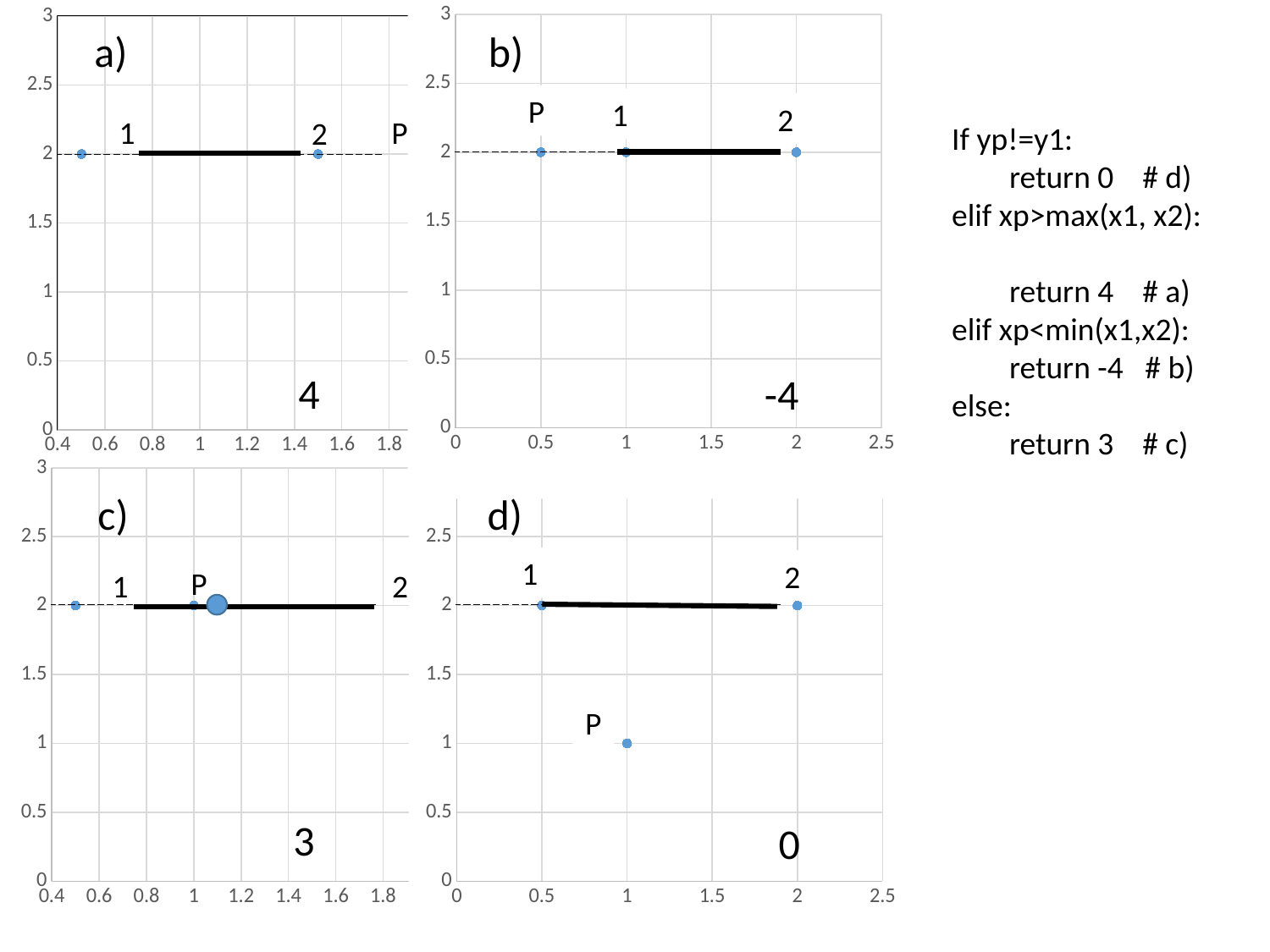
In chart d), what is the x value of point P? 1 In chart b), what is the x value of point P? 0.5 What number is printed in the lower right of chart b)? -4 How many charts are shown on the slide? 4 In chart b), which point has the largest x value? 2 In chart c), which has the larger x value, point 1 or point P? P In chart a), is the x value of point P greater or less than 1.5? greater What kind of chart is chart a)? scatter chart In chart d), what is the y value of point P? 1 In chart b), what is the x value of point 2? 2 In chart d), which point has the lowest y value? P In chart d), what is the y value of point 1? 2